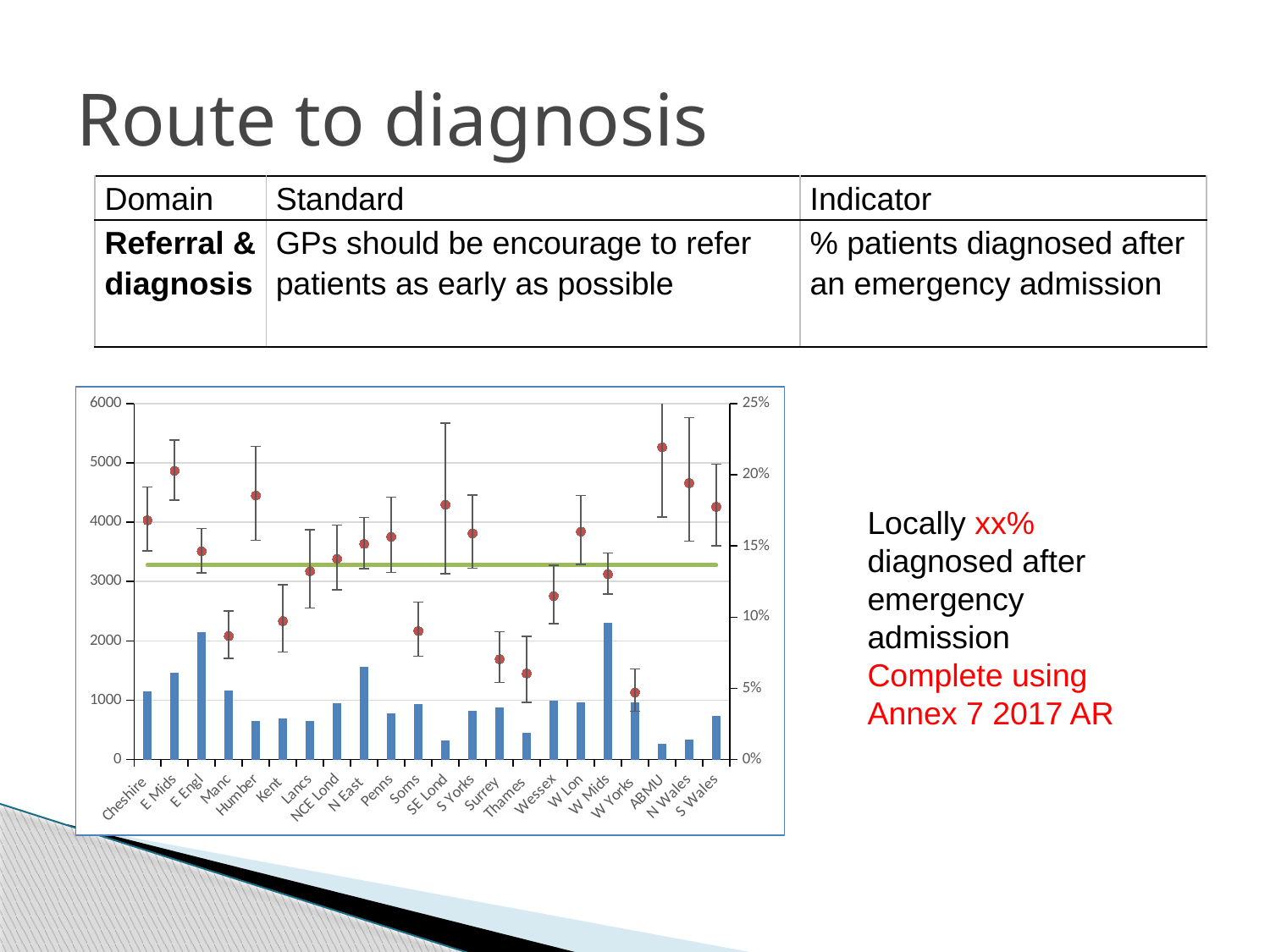
Is the bar value for W Mids greater or less than 2000? greater Which category has the highest red point value on the right-hand percentage axis? ABMU Is the red point value for ABMU greater or less than 20%? greater What is the maximum value shown on the right-hand axis of the chart? 25% How many categories are shown along the x axis of the chart? 22 Which category has the lowest red point value on the right-hand percentage axis? W Yorks Is the red point value for Surrey greater or less than 10%? less What kind of chart is shown on the slide? combination bar and line chart Which has the taller bar, E Mids or Kent? E Mids